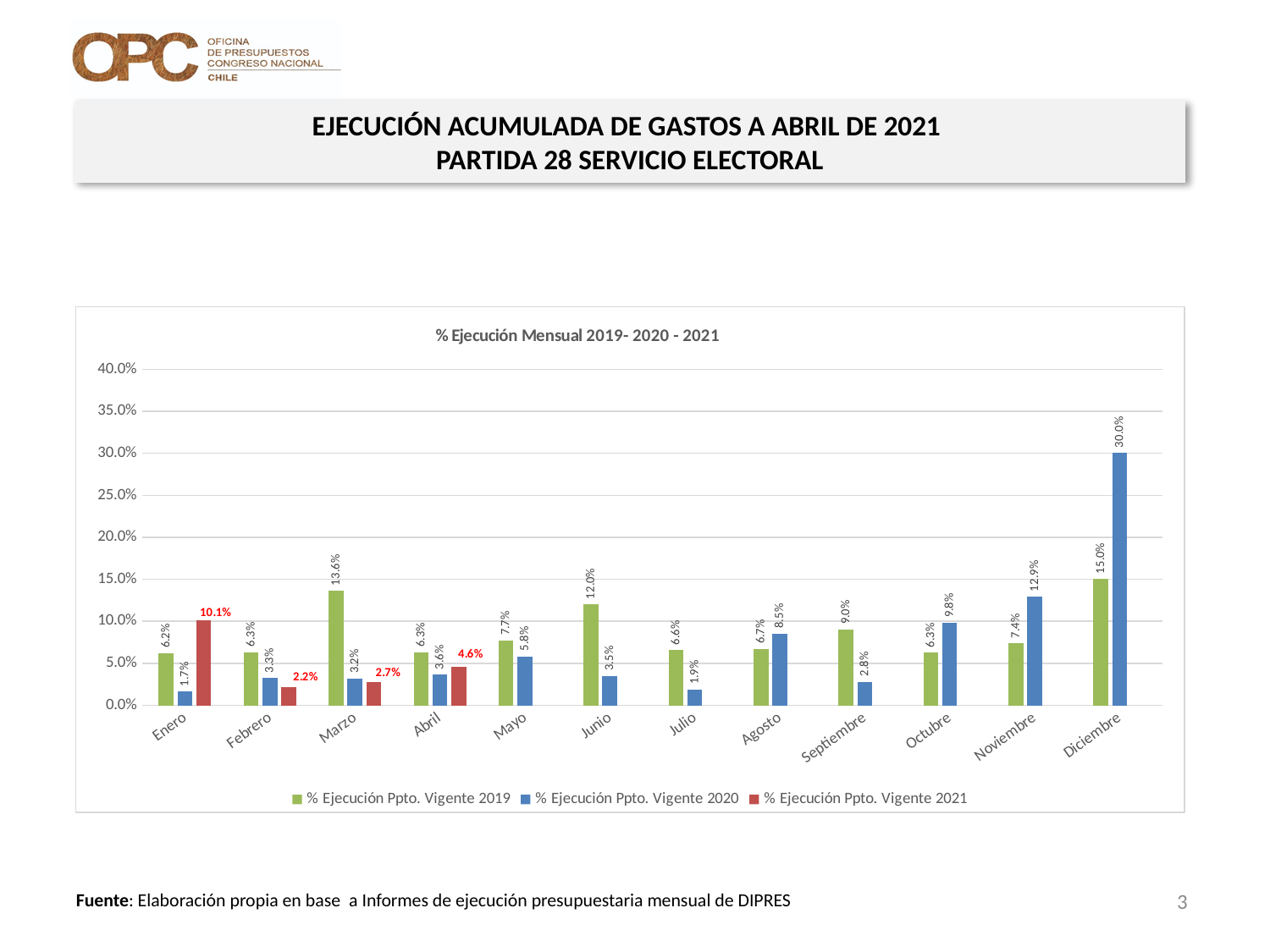
Is the value for Noviembre in the 2020 series greater or less than 10.0%? greater How many months are shown on the x axis? 12 What is the value for Diciembre in the % Ejecución Ppto. Vigente 2020 series? 30.0% What is the value for Enero in the % Ejecución Ppto. Vigente 2021 series? 10.1% What is the value for Marzo in the % Ejecución Ppto. Vigente 2019 series? 13.6% What is the difference between the 2020 and 2019 values for Diciembre? 15.0% Which month has the lowest value in the % Ejecución Ppto. Vigente 2020 series? Enero Which is larger for Agosto: the 2019 value or the 2020 value? 2020 Which month has the highest value in the % Ejecución Ppto. Vigente 2020 series? Diciembre What is the title of the chart? % Ejecución Mensual 2019- 2020 - 2021 What kind of chart is shown? Bar chart How many series does the legend list? 3